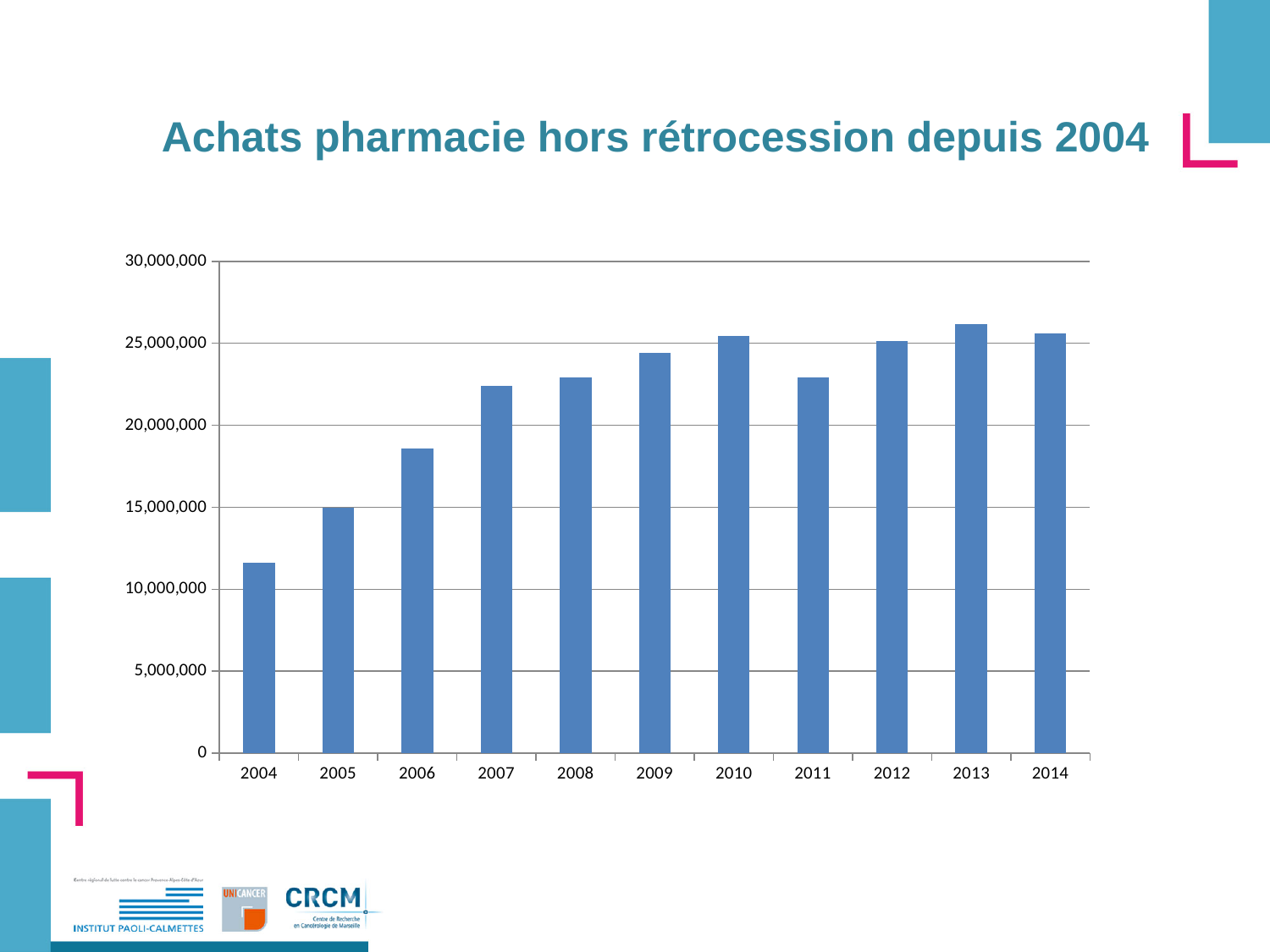
Which year has the highest value? 2013 Which year has the lowest value? 2004 How many years are plotted on the x axis? 11 What is the title of the chart? Achats pharmacie hors rétrocession depuis 2004 Which is larger, the value for 2006 or the value for 2007? 2007 Is the value for 2010 greater or less than 25,000,000? greater Is the value for 2006 greater or less than 20,000,000? less Is the value for 2004 greater or less than 10,000,000? greater Which is larger, the value for 2010 or the value for 2011? 2010 Do the values generally rise or fall from 2004 to 2014? rise What kind of chart is shown on the slide? bar chart